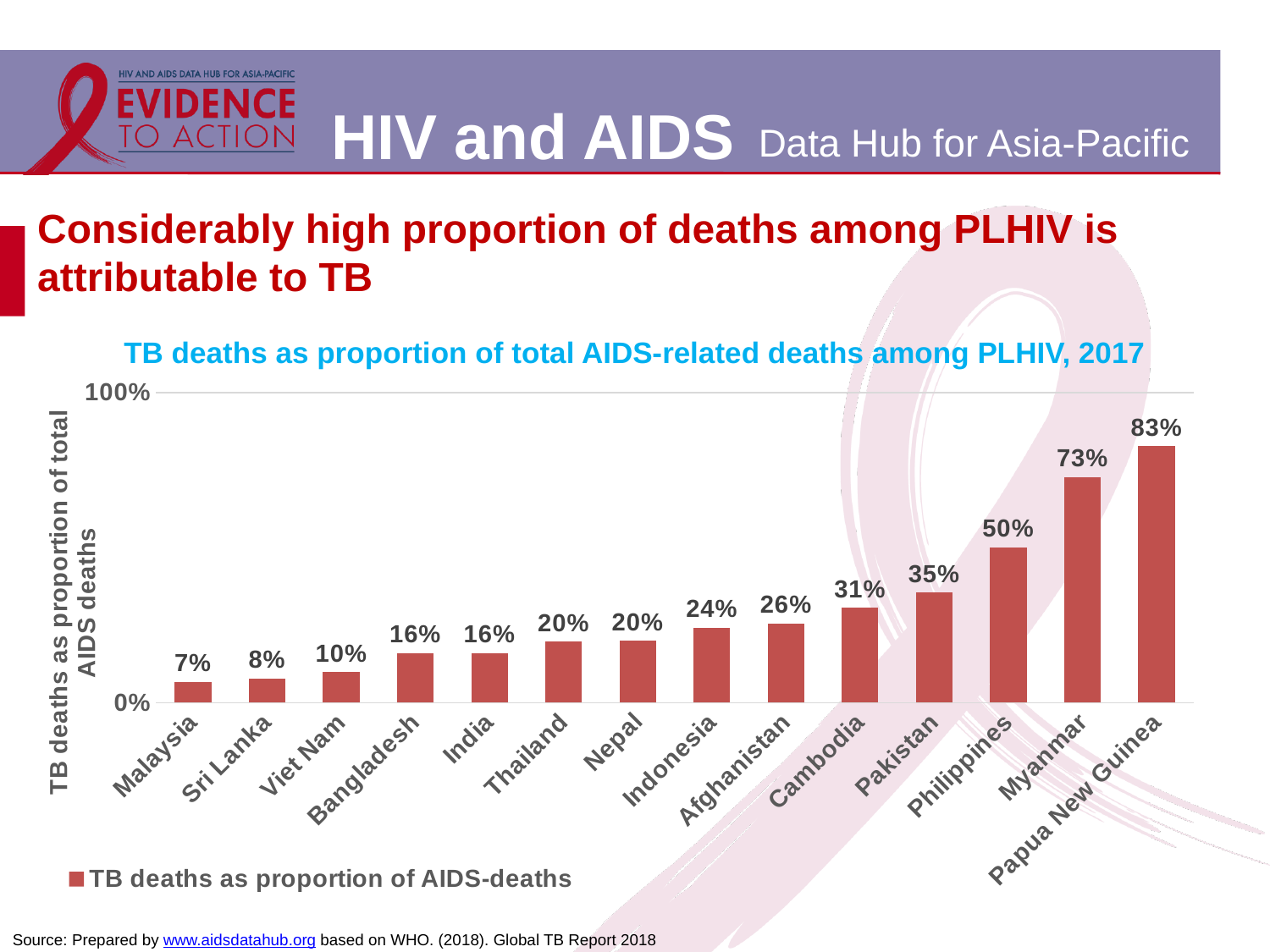
Which country has the highest value? Papua New Guinea What is the difference between the values for Myanmar and Philippines? 23% What is the value for Viet Nam? 10% Which country has the lowest value? Malaysia What is the value for Papua New Guinea? 83% How many series does the legend list? 1 How many countries are shown on the chart? 14 What is the value for Cambodia? 31% What kind of chart is shown? Bar chart Do the values rise or fall from left to right along the x axis? Rise What is the title of the chart? TB deaths as proportion of total AIDS-related deaths among PLHIV, 2017 Which is larger, the value for Pakistan or the value for Indonesia? Pakistan